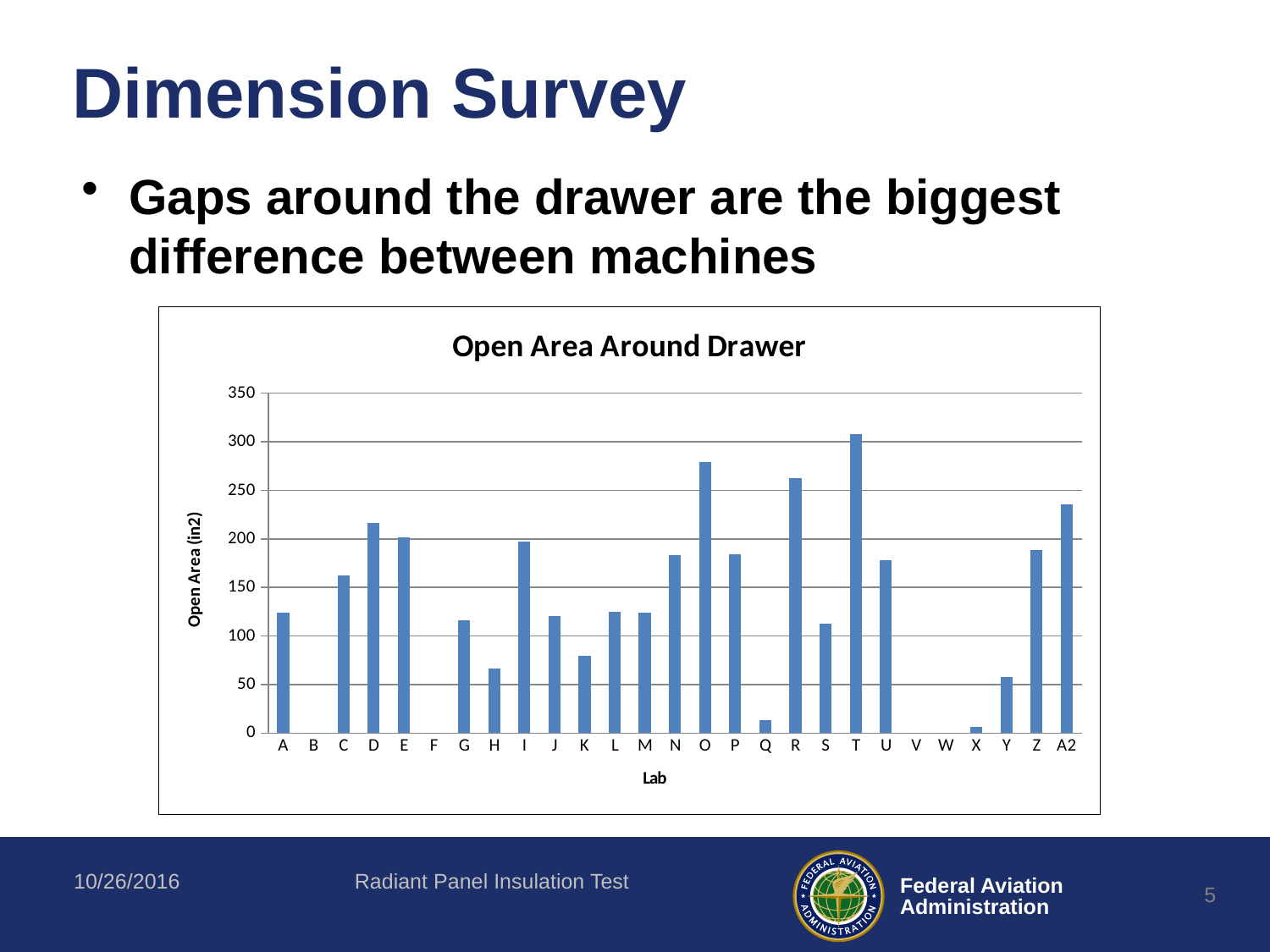
Is the value for lab A2 greater or less than 200? greater Is the value for lab H greater or less than 100? less Which lab has the larger open area, D or C? D How many lab categories are listed along the x axis? 27 Is the value for lab O greater or less than 250? greater What is the label of the vertical axis of the chart? Open Area (in2) What is the title of the chart? Open Area Around Drawer Which lab has the larger open area, T or O? T Which lab has the highest open area around the drawer? T What kind of chart is shown on the slide? Bar chart